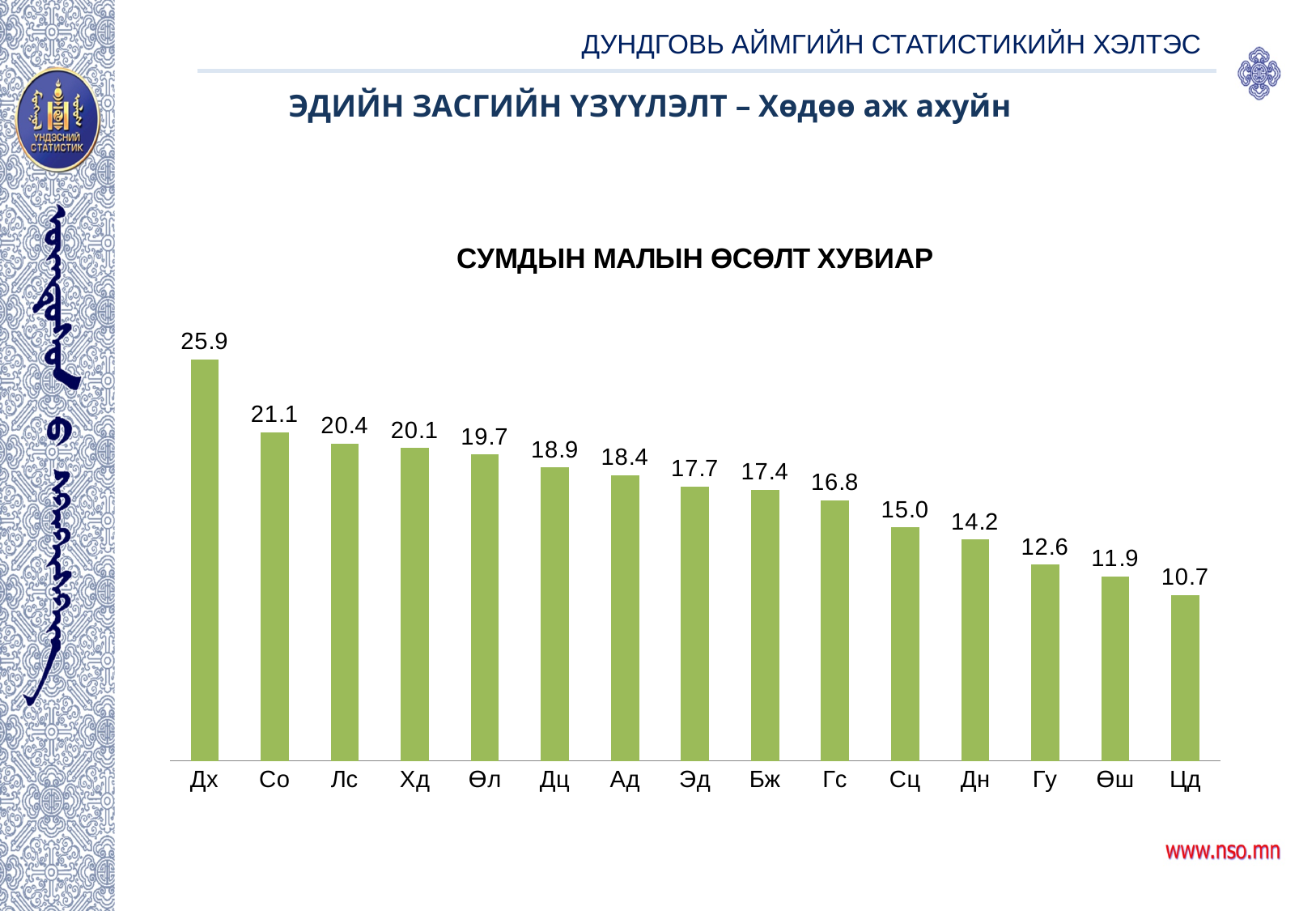
What is the difference between the values for Дх and Со? 4.8 Which category has the highest value? Дх What is the value for Цд? 10.7 What kind of chart is this? Bar chart Which category has the lowest value? Цд What is the value for Дх? 25.9 Do the values rise or fall from left to right along the x axis? Fall What is the value for Гс? 16.8 What is the difference between the values for Сц and Гу? 2.4 Which is larger, the value for Лс or the value for Дн? Лс What is the title of the chart? СУМДЫН МАЛЫН ӨСӨЛТ ХУВИАР How many categories are shown on the x axis? 15